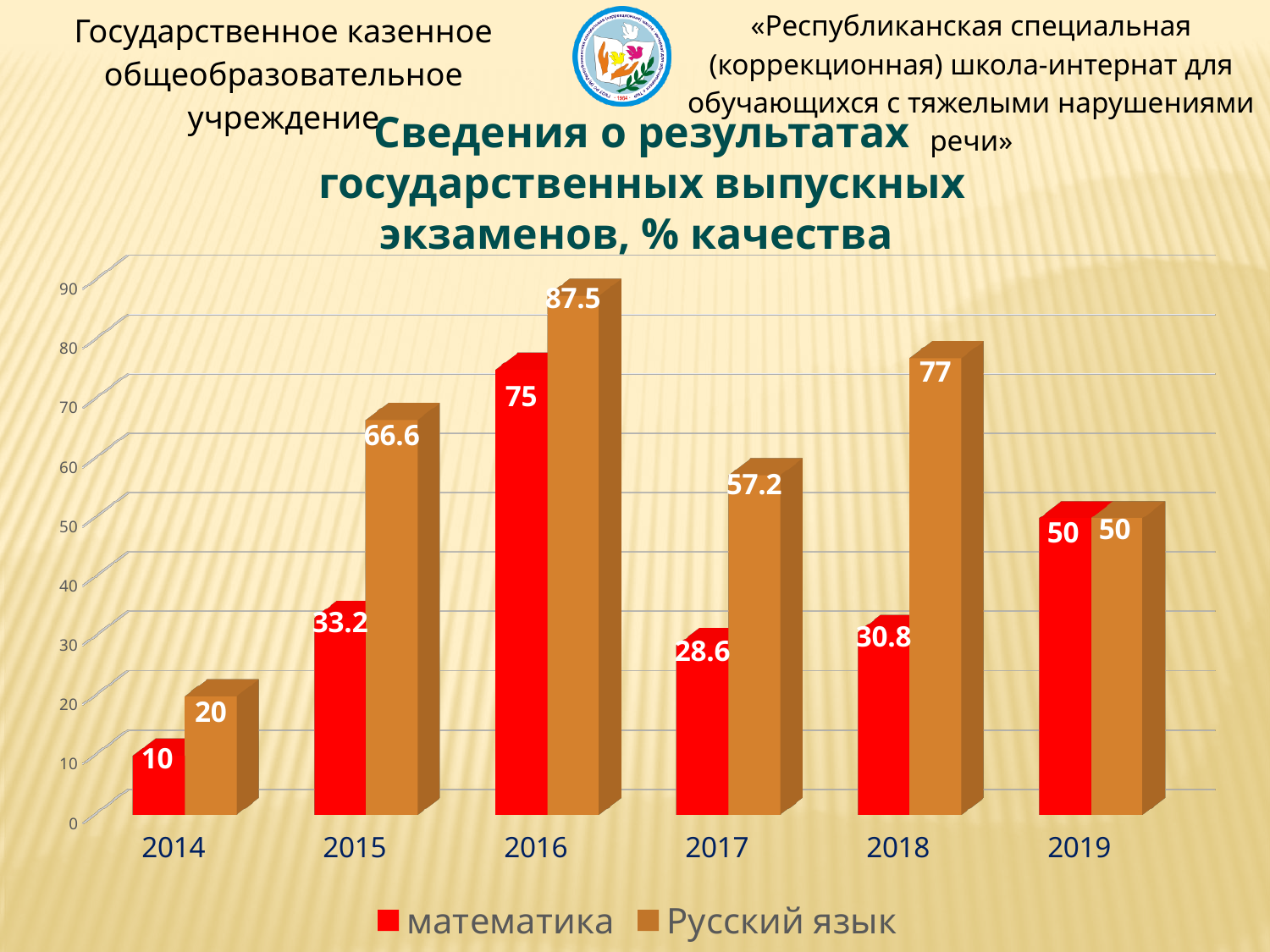
Which is larger in 2018: математика or Русский язык? Русский язык Which colour represents математика in the legend? red What is the difference between Русский язык and математика in 2015? 33.4 What kind of chart is shown on the slide? bar chart What is the value for Русский язык in 2018? 77 What is the value for математика in 2016? 75 What is the value for математика in 2017? 28.6 In which year is the value for математика lowest? 2014 How many series does the legend list? 2 How many years are shown on the x axis? 6 Does the value for математика rise or fall from 2016 to 2017? fall In which year is the value for Русский язык highest? 2016